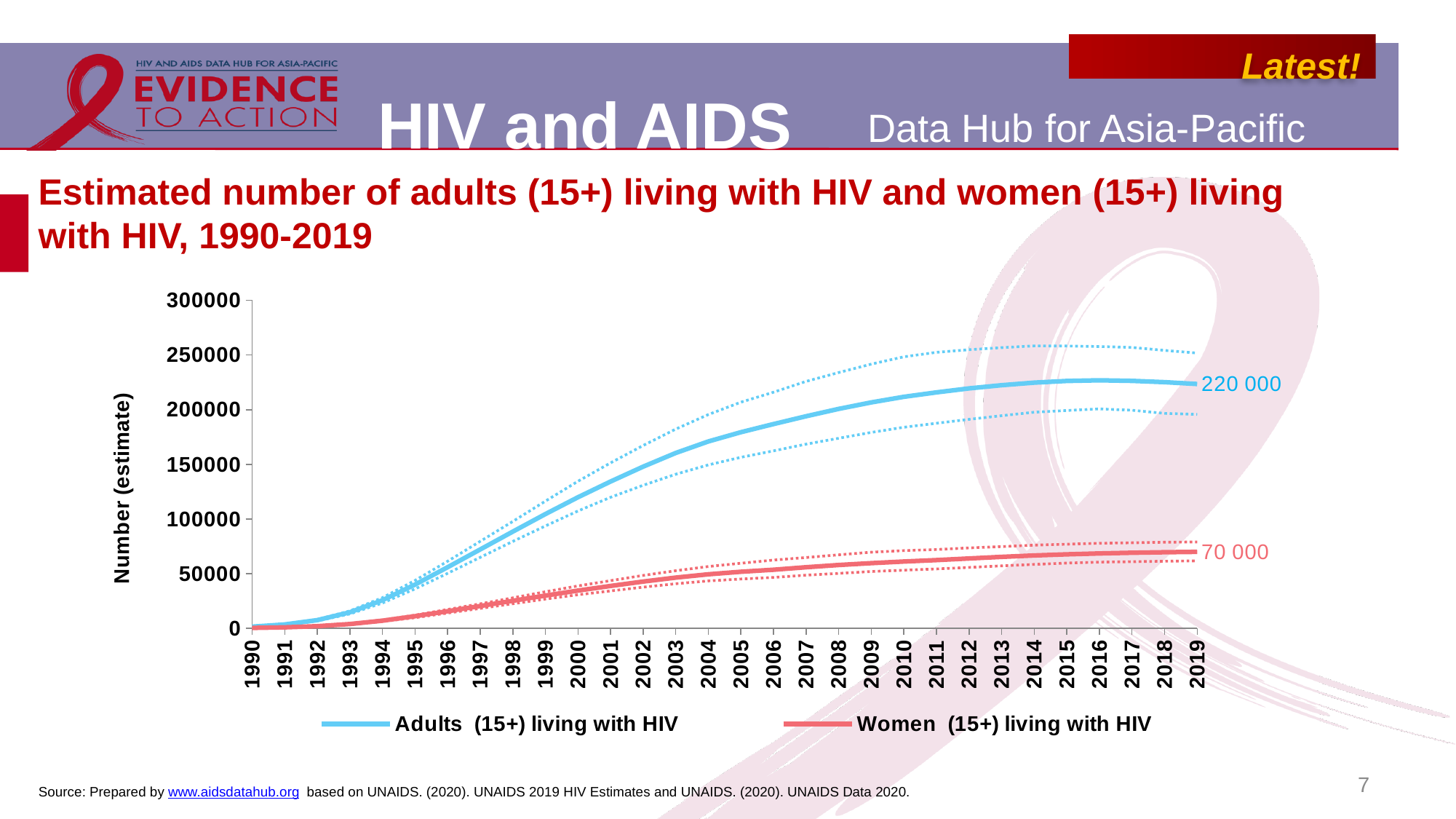
What colour is the line for Women (15+) living with HIV? Red What is the labelled value for Women (15+) living with HIV in 2019? 70 000 What is the difference between the 2019 values for Adults (15+) living with HIV and Women (15+) living with HIV? 150 000 Is the value for Adults (15+) living with HIV in 2005 greater or less than 150000? greater What is the label of the vertical axis? Number (estimate) Does the Adults (15+) living with HIV line generally rise or fall from 1990 to 2015? Rise What is the labelled value for Adults (15+) living with HIV in 2019? 220 000 Is the value for Women (15+) living with HIV in 2000 greater or less than 50000? less Is the value for Adults (15+) living with HIV in 1995 greater or less than 50000? less In 2019, which series has the larger value: Adults (15+) living with HIV or Women (15+) living with HIV? Adults (15+) living with HIV How many series does the legend list? 2 What kind of chart is shown on the slide? Line chart